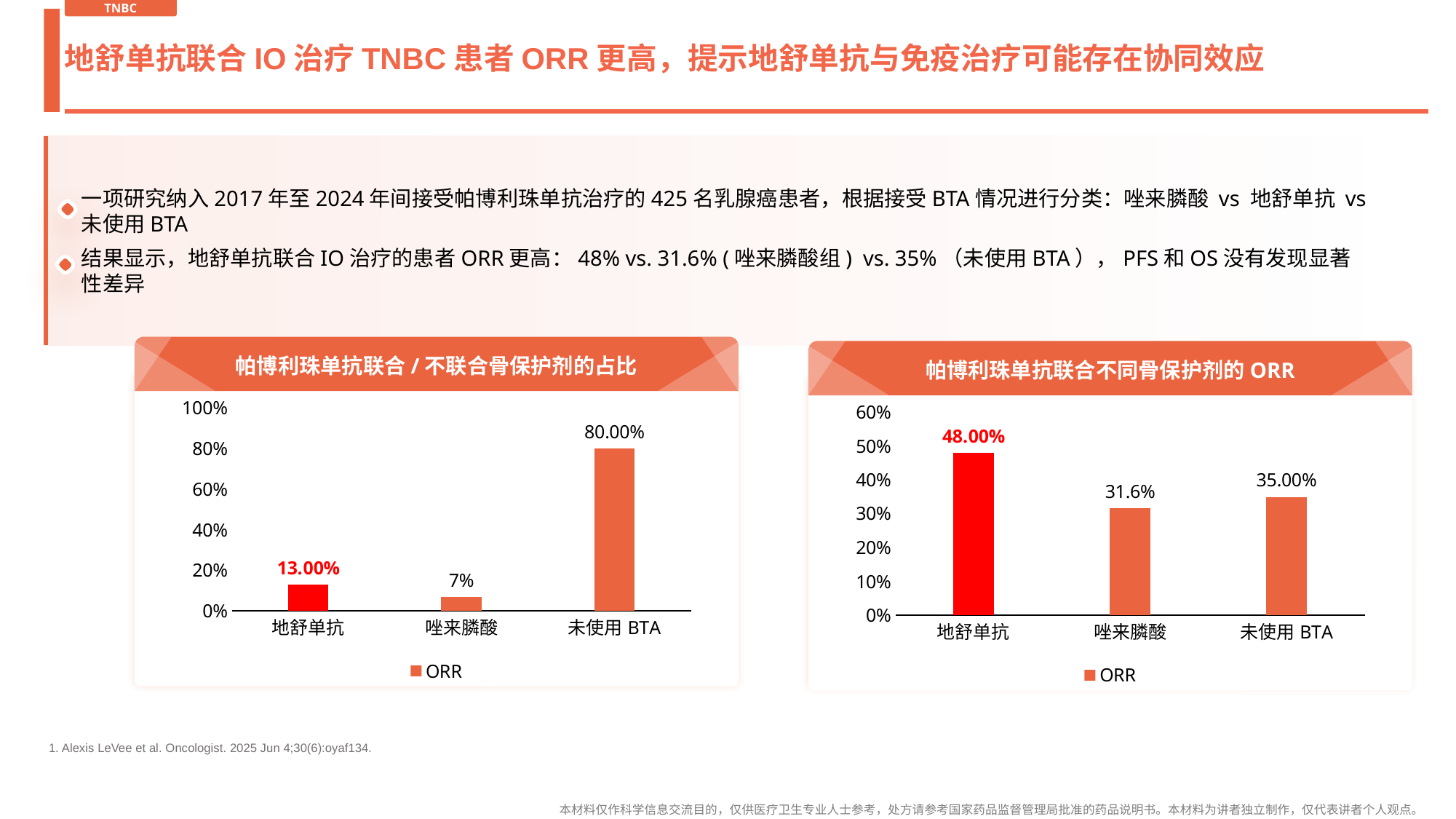
In the left chart (帕博利珠单抗联合/不联合骨保护剂的占比), which category has the lowest value? 唑来膦酸 In the right chart (帕博利珠单抗联合不同骨保护剂的 ORR), which category has the highest ORR? 地舒单抗 What kind of chart is the right chart (帕博利珠单抗联合不同骨保护剂的 ORR)? bar chart In the right chart (帕博利珠单抗联合不同骨保护剂的 ORR), is the value for 地舒单抗 greater or less than 40%? greater In the right chart (帕博利珠单抗联合不同骨保护剂的 ORR), which is larger, the ORR for 未使用 BTA or for 唑来膦酸? 未使用 BTA In the right chart (帕博利珠单抗联合不同骨保护剂的 ORR), what is the ORR for 地舒单抗? 48.00% In the left chart (帕博利珠单抗联合/不联合骨保护剂的占比), what is the value for 未使用 BTA? 80.00% In the left chart (帕博利珠单抗联合/不联合骨保护剂的占比), what is the value for 地舒单抗? 13.00% In the left chart (帕博利珠单抗联合/不联合骨保护剂的占比), what is the difference between 未使用 BTA and 地舒单抗? 67.00% In the right chart (帕博利珠单抗联合不同骨保护剂的 ORR), how many series does the legend list? 1 In the left chart (帕博利珠单抗联合/不联合骨保护剂的占比), how many categories are shown? 3 In the right chart (帕博利珠单抗联合不同骨保护剂的 ORR), what is the ORR for 唑来膦酸? 31.6%